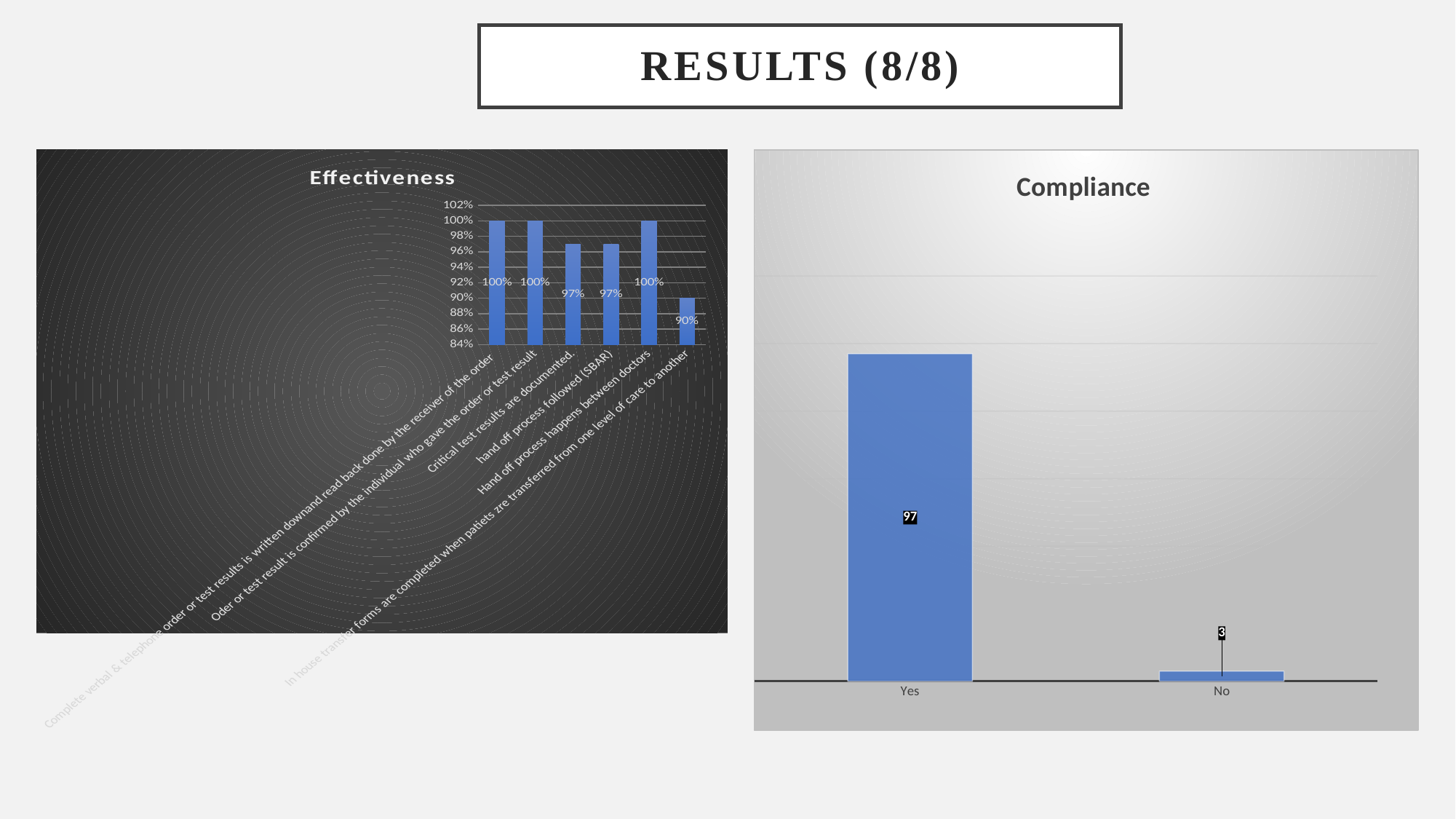
In the Effectiveness chart, how many categories are plotted? 6 In the Effectiveness chart, is the value for "Critical test results are documented." greater or less than 94%? greater In the Compliance chart, what is the value for "Yes"? 97 In the Effectiveness chart, what is the difference between the value for "hand off process followed (SBAR)" and the value for "In house transfer forms are completed when patiets zre transferred from one level of care to another"? 7% In the Compliance chart, what is the difference between the values for "Yes" and "No"? 94 In the Effectiveness chart, what is the value for "In house transfer forms are completed when patiets zre transferred from one level of care to another"? 90% In the Compliance chart, which category is larger, "Yes" or "No"? Yes In the Effectiveness chart, what is the value for "Hand off process happens between doctors"? 100% In the Effectiveness chart, which category has the lowest value? In house transfer forms are completed when patiets zre transferred from one level of care to another What kind of chart is the Compliance chart? bar chart In the Compliance chart, what is the value for "No"? 3 In the Effectiveness chart, what is the value for "Critical test results are documented."? 97%